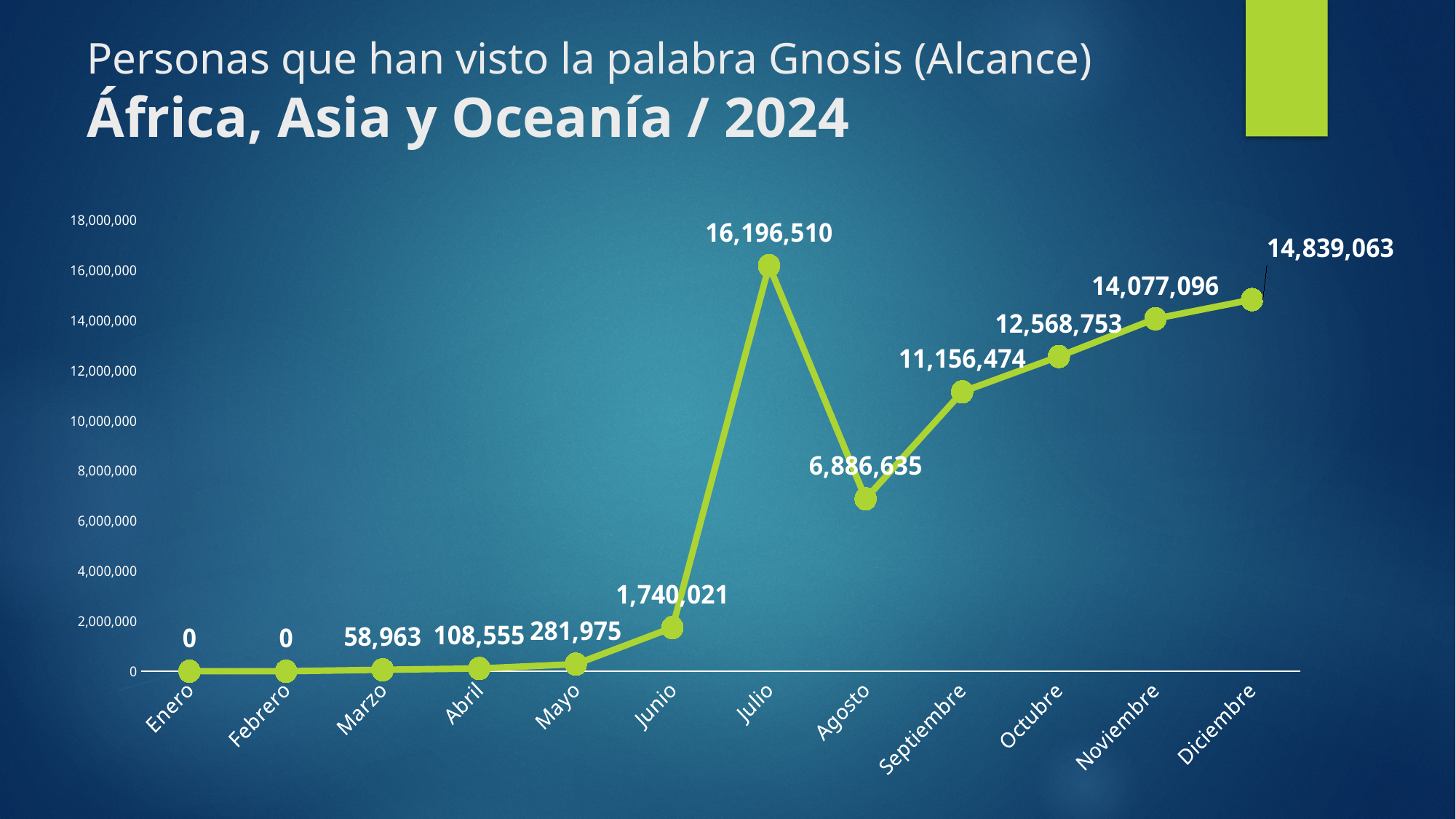
What is the difference between the values for Julio and Agosto? 9,309,875 What is the value for Julio? 16,196,510 Which month has the highest value? Julio Do the values rise or fall from Agosto to Diciembre? Rise What kind of chart is shown on the slide? Line chart How many months are plotted on the chart? 12 Is the value for Septiembre greater or less than 10,000,000? greater What is the value for Diciembre? 14,839,063 What is the difference between the values for Diciembre and Noviembre? 761,967 What is the value for Agosto? 6,886,635 What is the value for Marzo? 58,963 Which is larger, the value for Junio or the value for Mayo? Junio